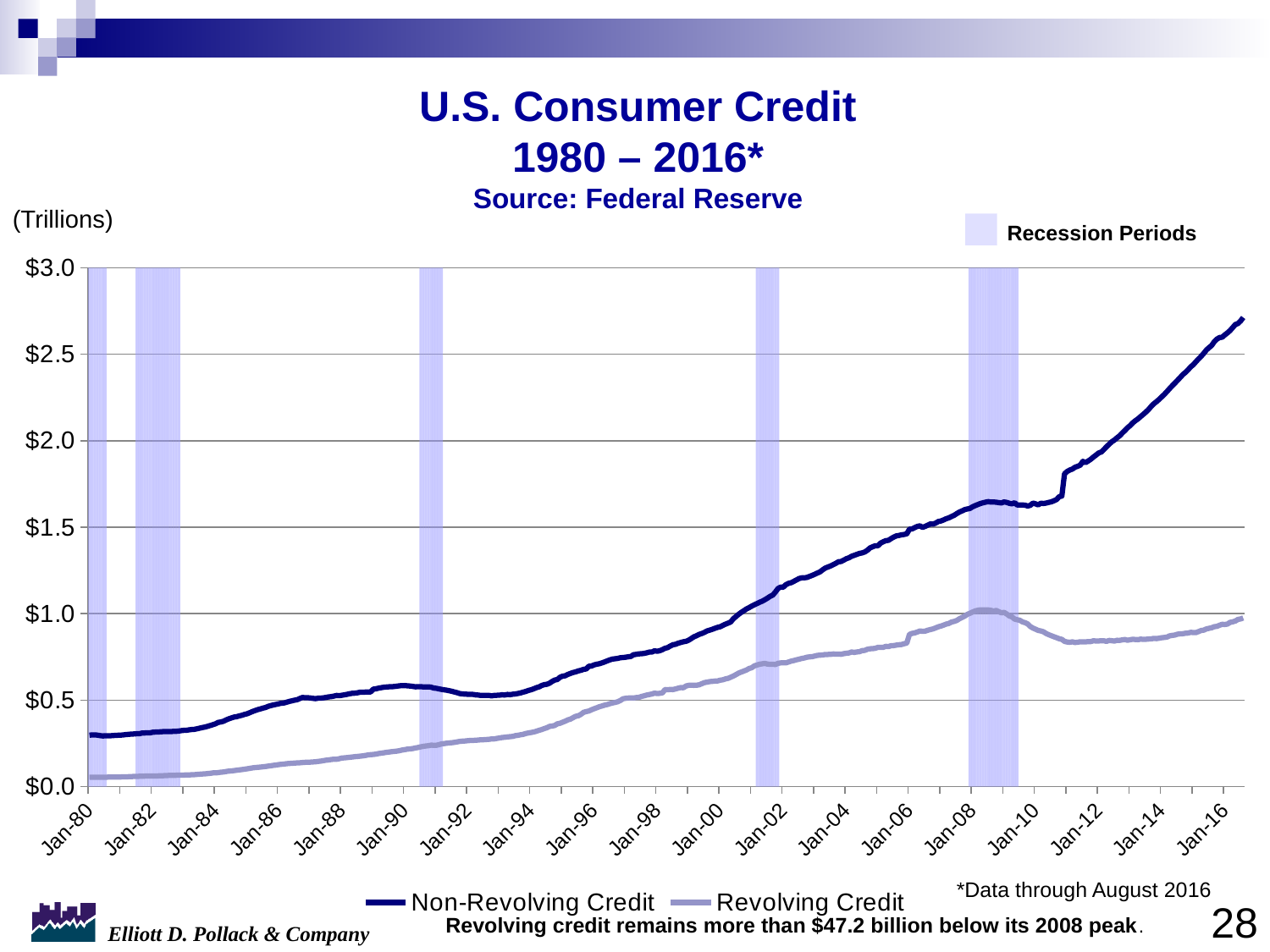
How many series does the chart legend list? 2 Is the value for Revolving Credit at Jan-12 greater or less than $1.0? less Is the value for Non-Revolving Credit at Jan-80 greater or less than $0.5? less What are the two series named in the legend? Non-Revolving Credit and Revolving Credit Is the value for Non-Revolving Credit at Jan-04 greater or less than $1.0? greater What kind of chart is shown on the slide? Line chart Does Non-Revolving Credit generally rise or fall from Jan-10 to Jan-16? rise Does Revolving Credit rise or fall between Jan-08 and Jan-10? fall What unit is the y axis measured in, according to the label above the chart? Trillions At Jan-16, which series is higher, Non-Revolving Credit or Revolving Credit? Non-Revolving Credit